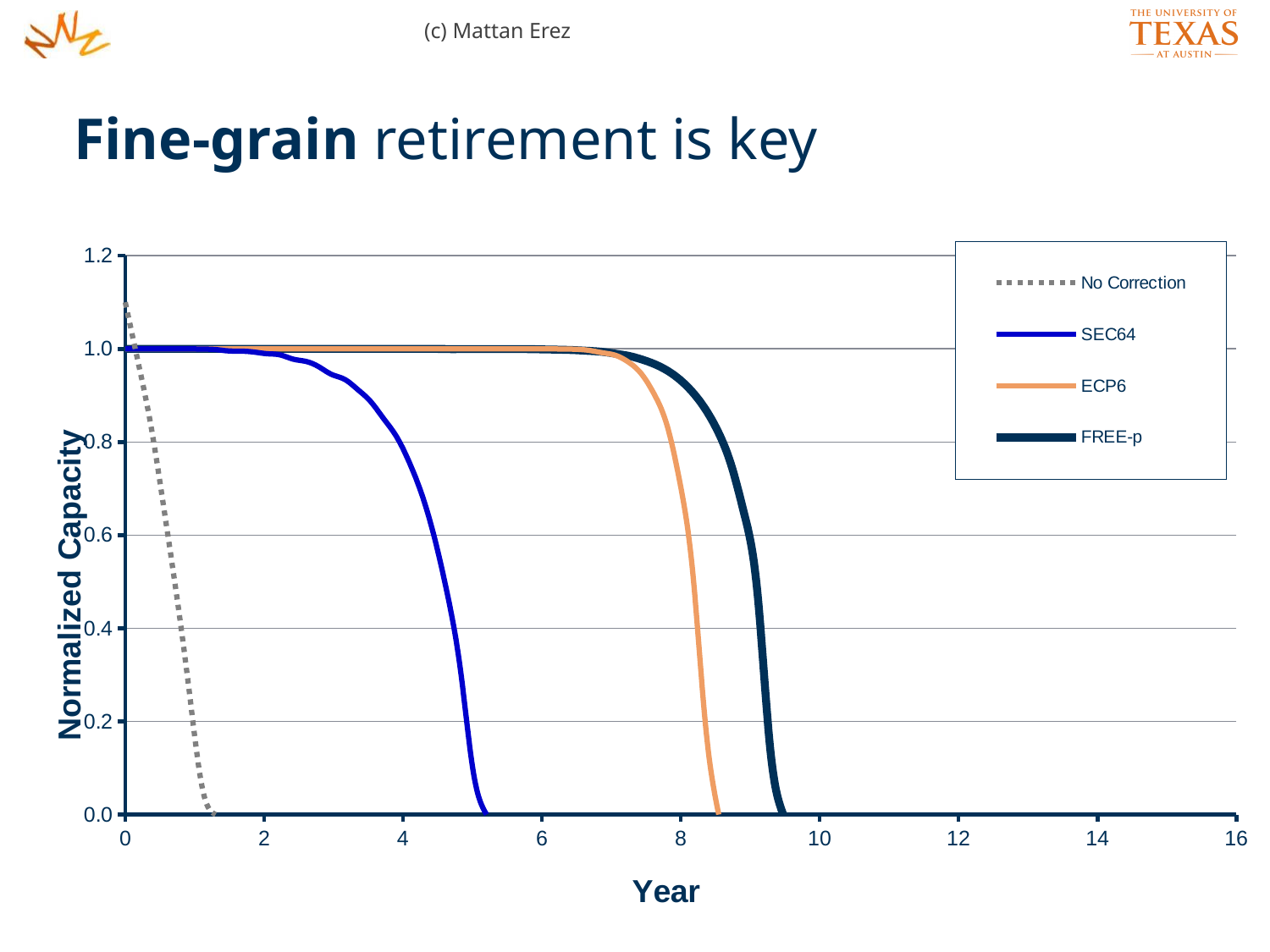
What is the label of the chart's x axis? Year How many series does the chart's legend list? 4 At year 5, which series has the higher normalized capacity, SEC64 or ECP6? ECP6 Is the value for ECP6 at year 7 greater or less than 0.8? greater Does the SEC64 series rise or fall as the year increases? fall Is the value for SEC64 at year 3 greater or less than 0.8? greater Which series keeps its normalized capacity above zero for the longest time? FREE-p Which series drops to zero normalized capacity first? No Correction Is the value for FREE-p at year 8 greater or less than 0.8? greater What are the series names listed in the chart's legend? No Correction, SEC64, ECP6, FREE-p What kind of chart is shown on the slide? line chart